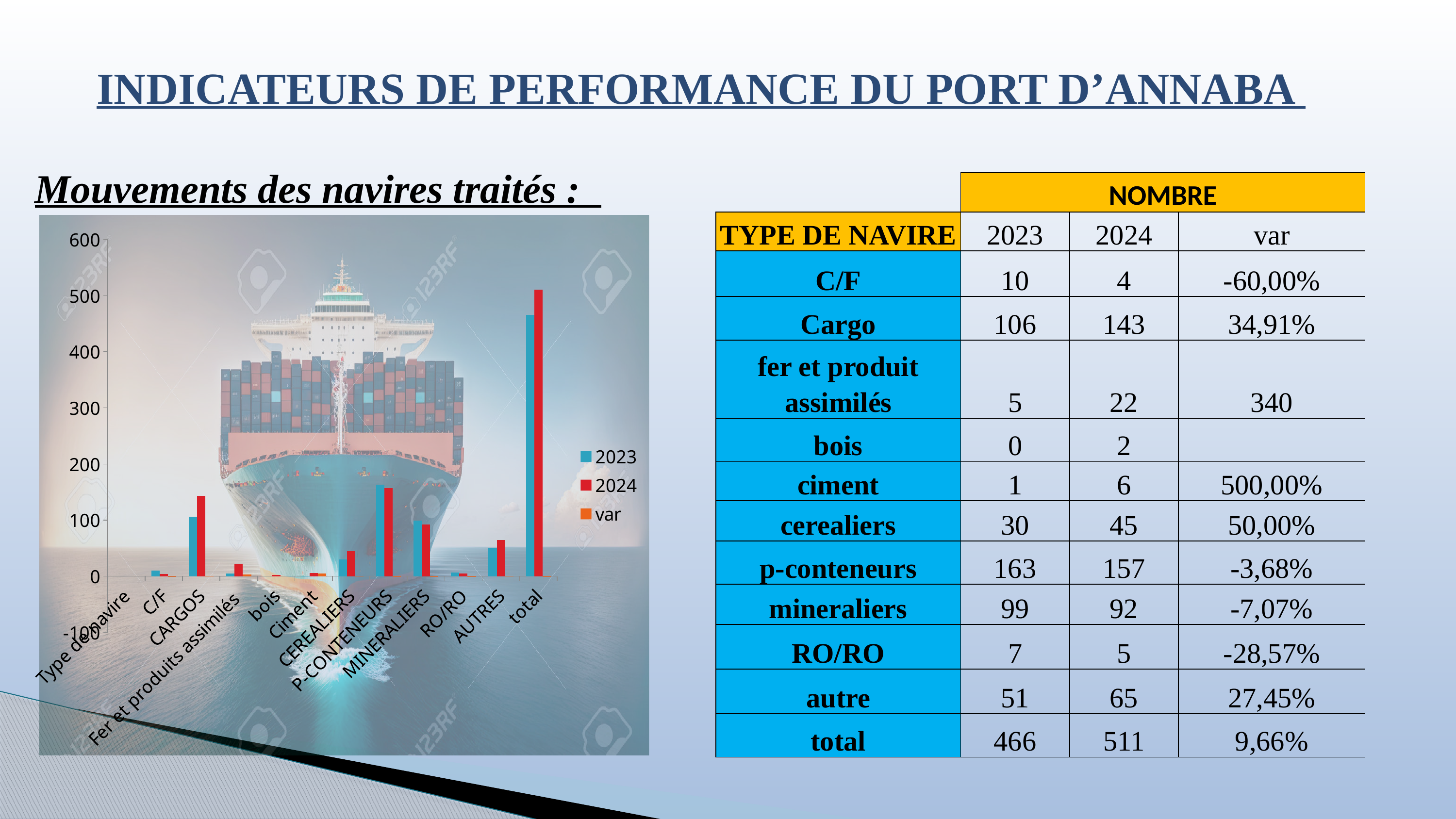
What is the 2023 value for 'CARGOS'? 106 For 'CEREALIERS', which bar is taller, 2023 or 2024? 2024 What kind of chart is shown under 'Mouvements des navires traités'? bar chart Which series is shown in red in the chart? 2024 What is the 2024 value for 'total'? 511 What is the difference between the 2024 and 2023 values for 'total'? 45 How many series does the chart legend list? 3 Is the 2023 value for 'MINERALIERS' greater or less than 200? less For 'CARGOS', which bar is taller, 2023 or 2024? 2024 Is the 2024 value for 'CARGOS' greater or less than 100? greater Is the 2023 value for 'total' greater or less than 500? less Apart from 'total', which category has the tallest 2023 bar? P-CONTENEURS